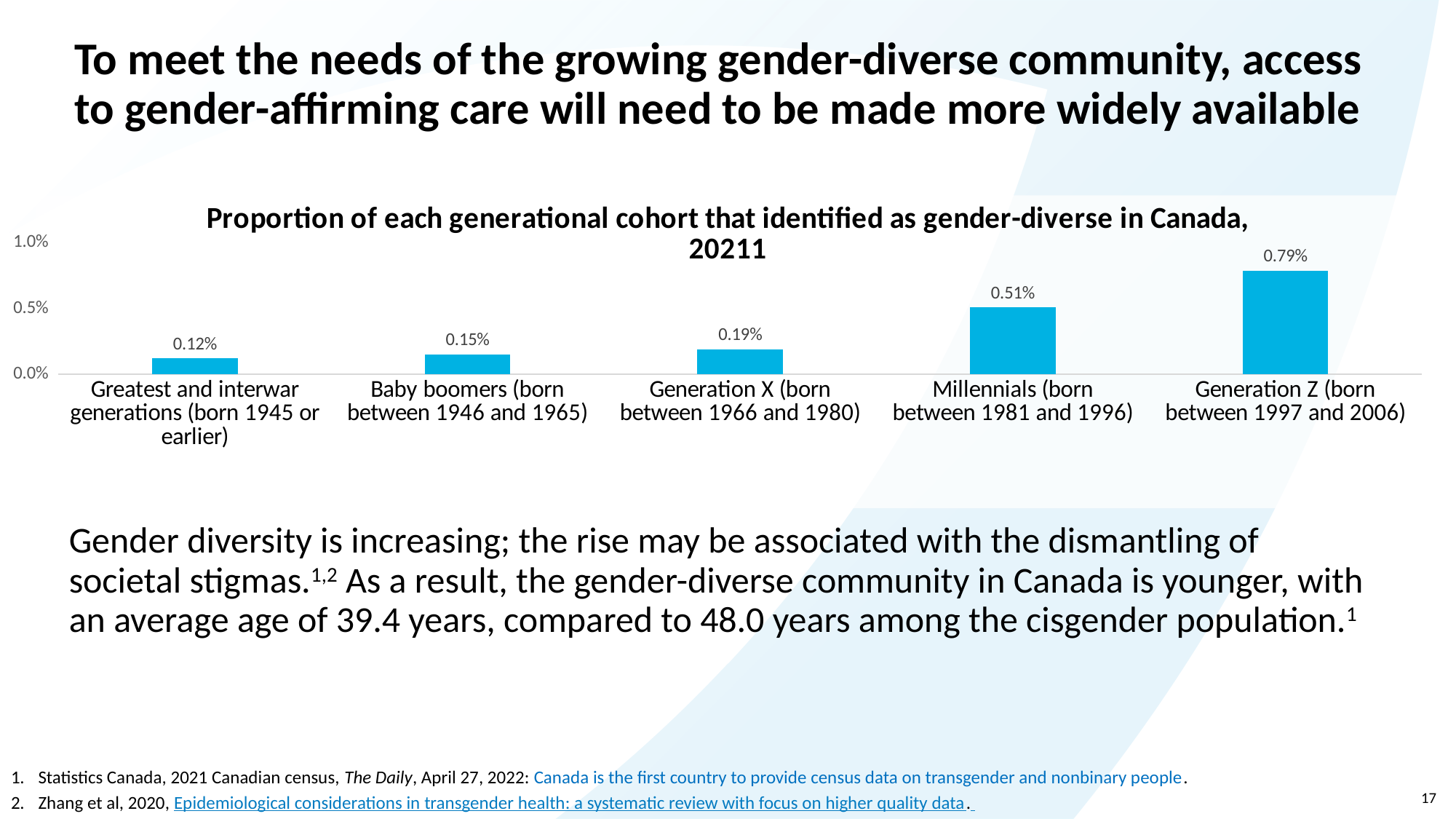
What is the value for Baby boomers (born between 1946 and 1965)? 0.15% Which generational cohort has the lowest proportion identifying as gender-diverse? Greatest and interwar generations (born 1945 or earlier) Which is larger, the value for Millennials or the value for Generation X? Millennials Which generational cohort has the highest proportion identifying as gender-diverse? Generation Z (born between 1997 and 2006) What is the difference between the values for Generation Z and Millennials? 0.28% How many generational cohorts are shown in the chart? 5 What is the value for Generation Z (born between 1997 and 2006)? 0.79% What is the value for Millennials (born between 1981 and 1996)? 0.51% What kind of chart is shown on the slide? Bar chart What is the difference between the values for Generation X and the Greatest and interwar generations? 0.07% Is the value for Generation Z greater or less than 0.5%? greater Do the values rise or fall moving from the oldest cohort on the left to the youngest on the right? Rise